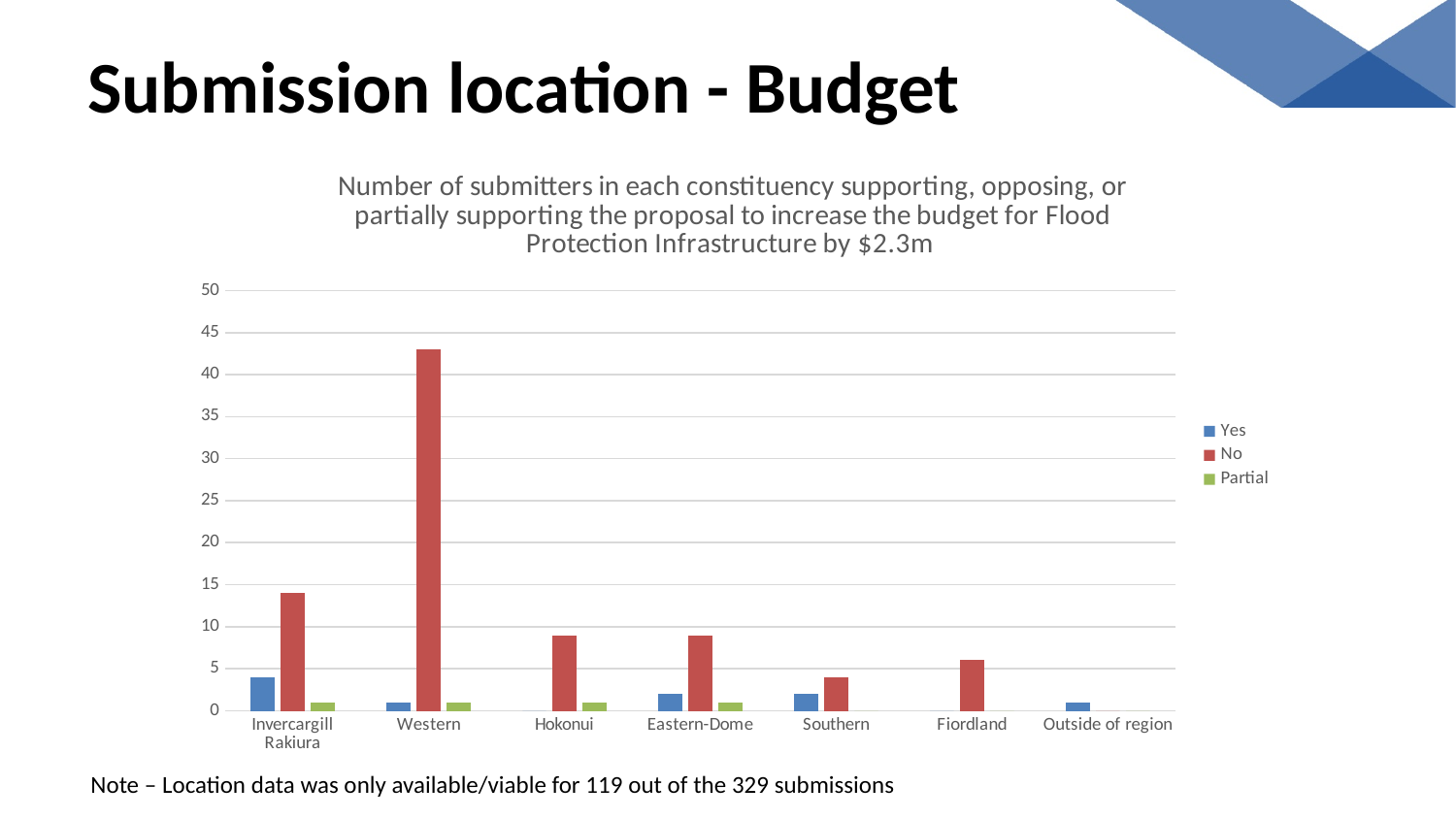
Is the 'No' value for Invercargill Rakiura greater or less than 10? greater Is the 'No' value for Fiordland greater or less than 10? less Is the 'No' value for Western greater or less than 40? greater How many constituency categories are shown on the x axis? 7 What are the three legend entries of the chart? Yes, No, Partial Which is larger, the 'No' value for Invercargill Rakiura or the 'No' value for Hokonui? Invercargill Rakiura How many series does the legend list? 3 What kind of chart is shown on the slide? bar chart Which is larger, the 'Yes' value for Invercargill Rakiura or the 'Yes' value for Western? Invercargill Rakiura Which constituency has the highest 'No' value? Western